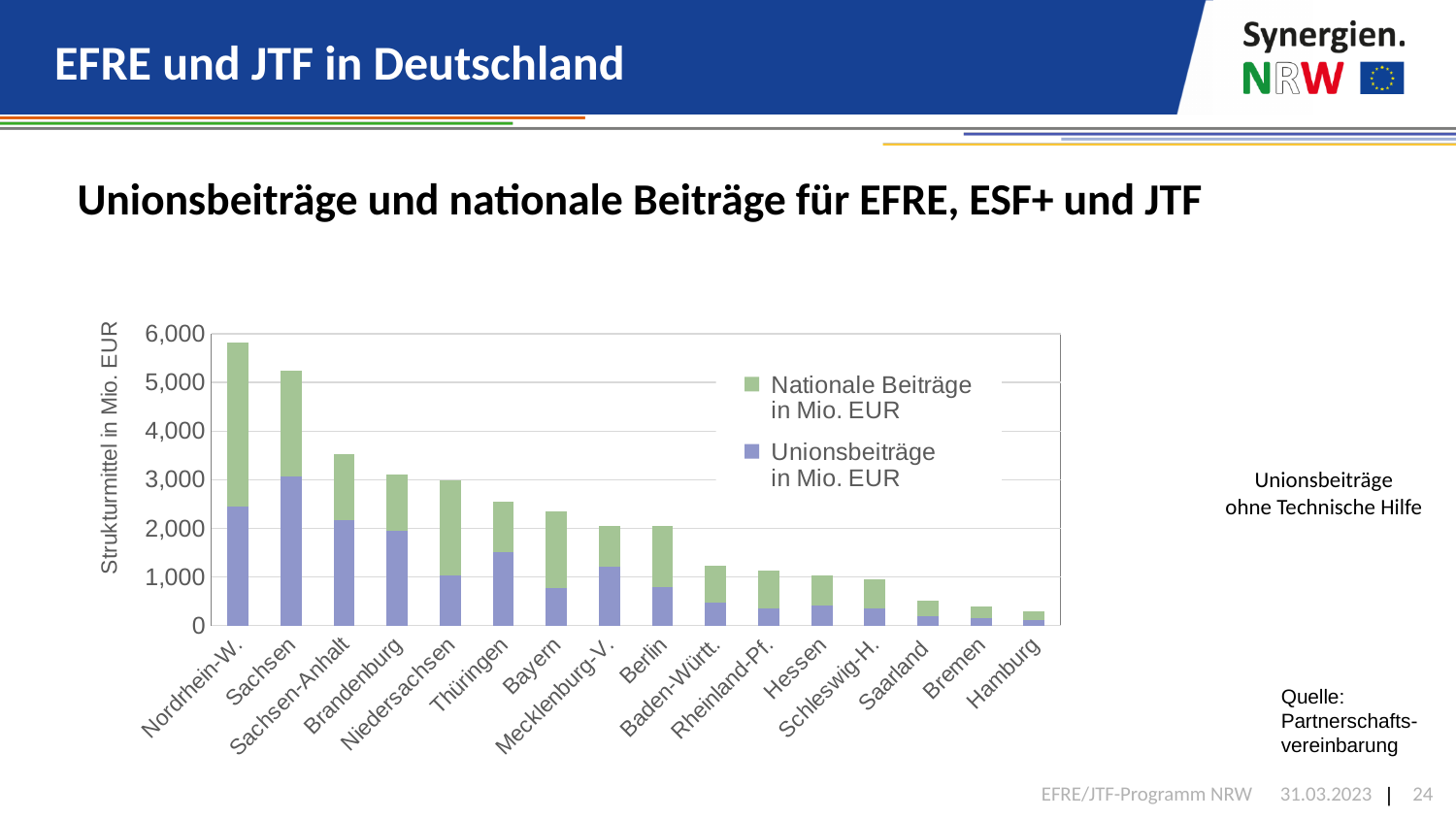
Is the total bar for Hamburg greater or less than 1,000? less Which is larger, the Unionsbeiträge for Sachsen or for Nordrhein-W.? Sachsen How many federal states (categories) are shown on the x axis of the chart? 16 What is the label of the vertical axis of the chart? Strukturmittel in Mio. EUR Is the total bar for Nordrhein-W. greater or less than 5,000? greater Is the Unionsbeiträge value for Thüringen greater or less than 1,000? greater What kind of chart is shown on the slide? Stacked bar chart Do the total bar values rise or fall moving from left to right along the x axis? fall Which federal state has the highest total bar (Unionsbeiträge plus Nationale Beiträge)? Nordrhein-W. How many series does the chart's legend list? 2 Which federal state has the lowest total bar in the chart? Hamburg Which federal state has the largest Unionsbeiträge segment? Sachsen